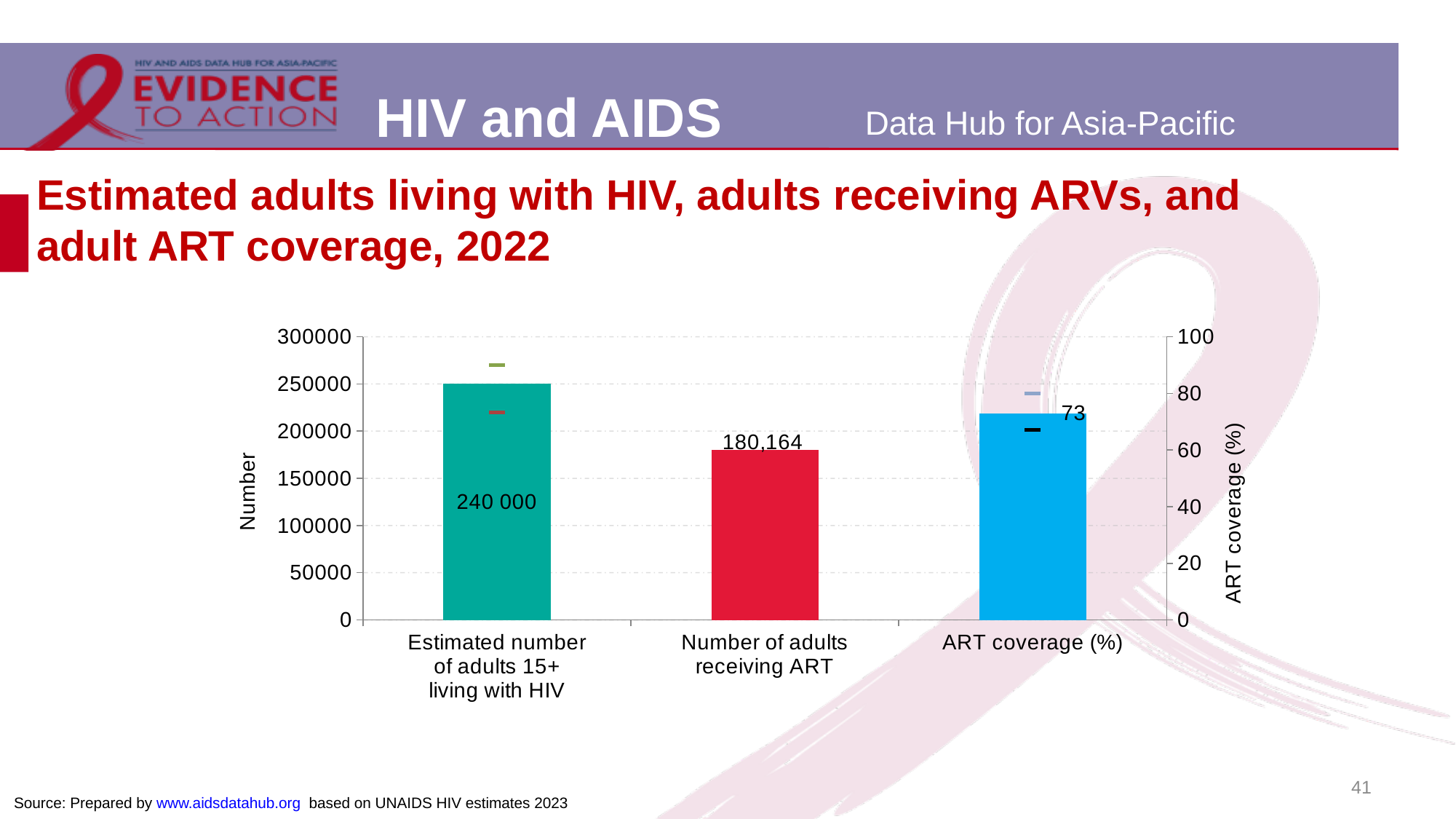
Which is larger: the estimated number of adults 15+ living with HIV or the number of adults receiving ART? Estimated number of adults 15+ living with HIV What is the difference between the estimated number of adults 15+ living with HIV (240 000) and the number of adults receiving ART (180,164)? 59,836 How many bars are plotted on the chart? 3 What is the estimated number of adults 15+ living with HIV shown on the chart? 240 000 What is the ART coverage (%) value shown on the chart? 73 Is the ART coverage (%) value greater or less than 60 on the right-hand axis? greater What is the title of the left vertical axis? Number What is the number of adults receiving ART shown on the chart? 180,164 What kind of chart is shown on the slide? Bar chart Is the value for the number of adults receiving ART greater or less than 200000? less What is the maximum value shown on the right-hand axis? 100 What is the title of the right vertical axis? ART coverage (%)